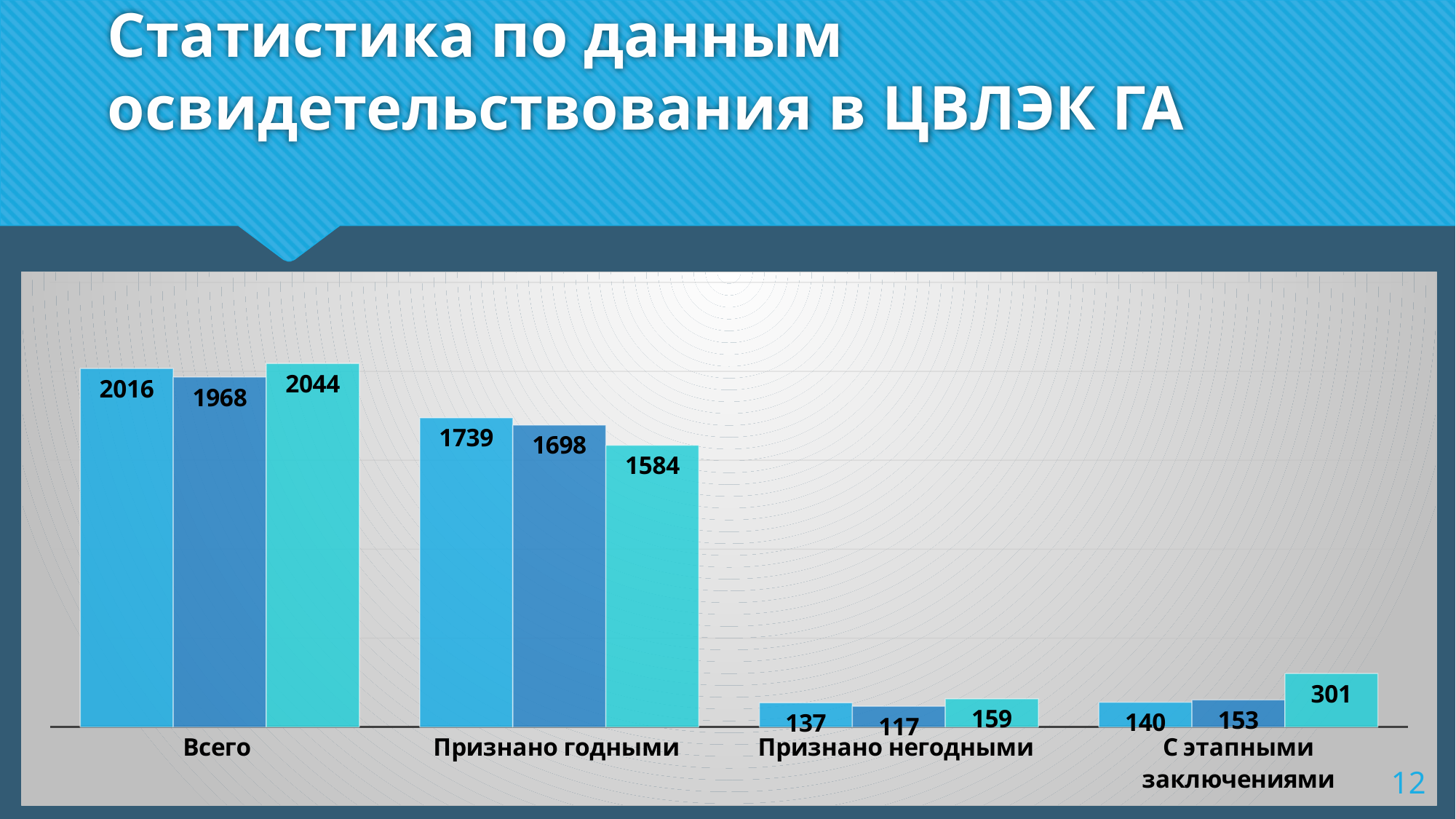
How many bars are shown in each category? 3 Which category has the lowest values overall? Признано негодными What is the value of the first (leftmost) bar in the "Всего" category? 2016 What is the value of the teal (third) bar in the "С этапными заключениями" category? 301 What is the value of the middle (dark blue) bar in the "Признано негодными" category? 117 What type of chart is shown on the slide? Bar chart Which bar in the "Всего" category has the highest value? The teal (third) bar, 2044 What is the difference between the teal bar and the first bar in the "Всего" category (2044 and 2016)? 28 Which is larger: the teal bar in "Признано негодными" or the teal bar in "С этапными заключениями"? С этапными заключениями (301) What is the difference between the first bar (1739) and the teal bar (1584) in the "Признано годными" category? 155 What is the value of the teal (third) bar in the "Признано годными" category? 1584 How many categories are shown on the x axis? 4